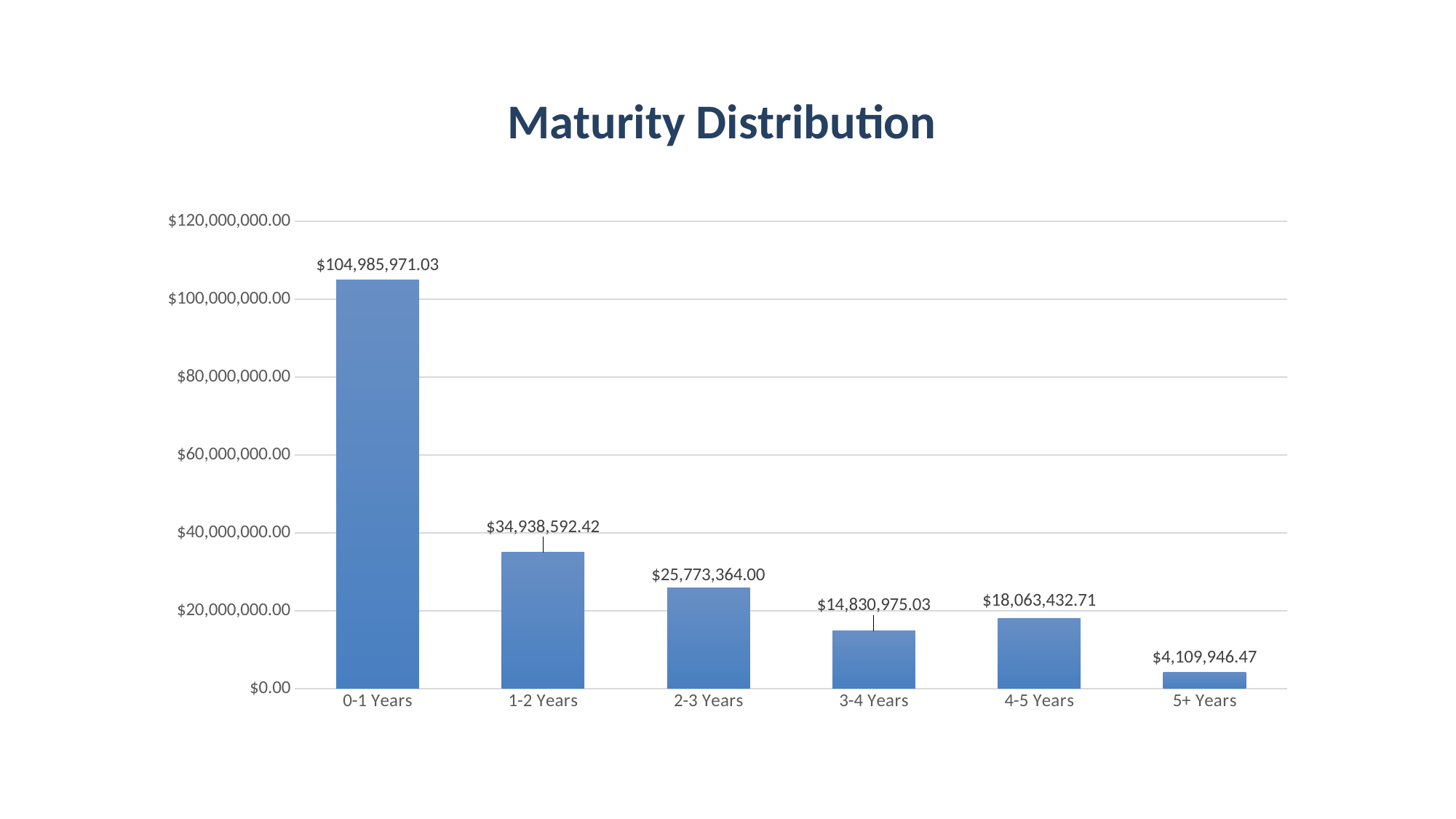
What is the value for 5+ Years? $4,109,946.47 What is the value for 3-4 Years? $14,830,975.03 Which maturity category has the highest value? 0-1 Years What is the difference between the values for 0-1 Years and 1-2 Years? $70,047,378.61 How many maturity categories are shown on the x axis? 6 From 0-1 Years to 3-4 Years, do the values rise or fall? fall What kind of chart is shown on the slide? bar chart Which maturity category has the lowest value? 5+ Years What is the difference between the values for 4-5 Years and 3-4 Years? $3,232,457.68 Is the value for 2-3 Years greater or less than $20,000,000.00? greater What is the value for 0-1 Years? $104,985,971.03 Which is larger, the value for 3-4 Years or the value for 4-5 Years? 4-5 Years